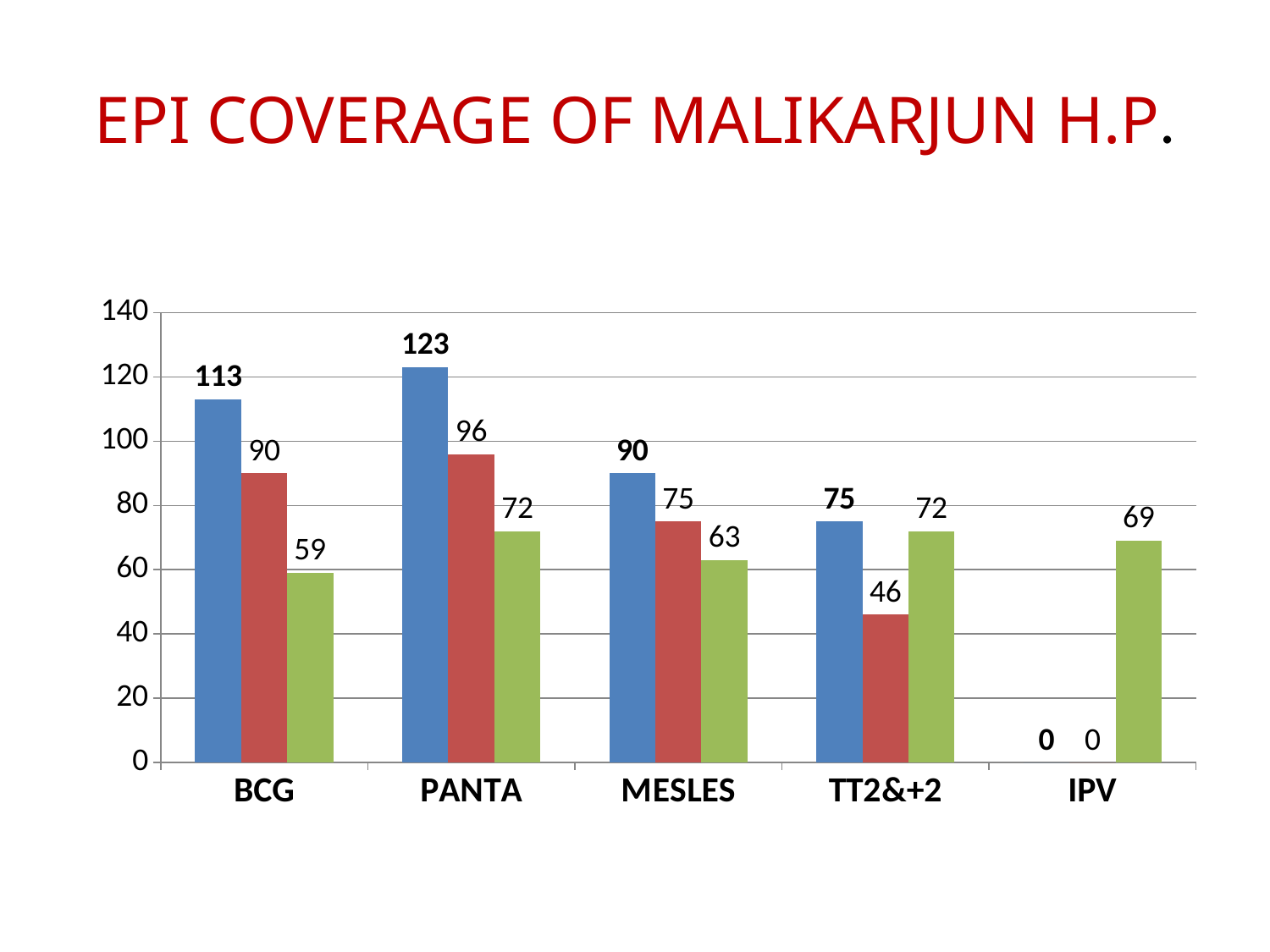
What is the value of the green bar for IPV? 69 What is the value of the red bar for TT2&+2? 46 What is the value of the blue bar for PANTA? 123 Which category has the highest blue bar? PANTA Which category has the lowest green bar? BCG Do the blue bar values rise or fall from PANTA to IPV? fall What is the difference between the blue bar and the red bar for BCG? 23 What kind of chart is shown on the slide? bar chart What is the value of the red bar for PANTA? 96 Which is larger for MESLES, the red bar or the green bar? the red bar What is the title of the slide? EPI COVERAGE OF MALIKARJUN H.P. How many categories are shown on the x axis? 5